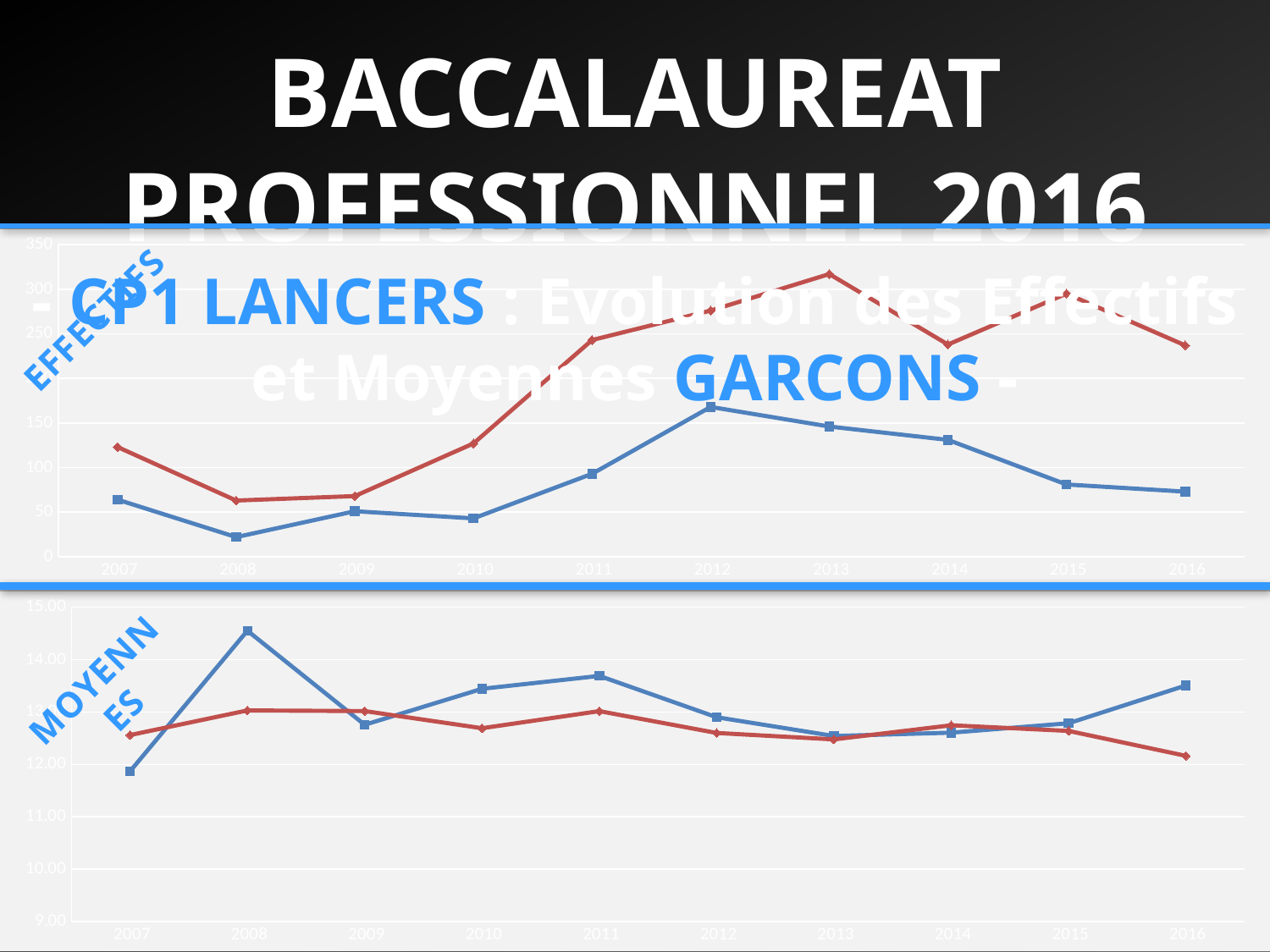
In the top chart (EFFECTIFS), in which year does the red line reach its highest value? 2013 In the bottom chart (MOYENNES), in which year does the blue line reach its highest value? 2008 In the bottom chart (MOYENNES), in which year is the red line at its lowest? 2016 In the top chart (EFFECTIFS), which line has the larger value in 2013, the red line or the blue line? the red line In the top chart (EFFECTIFS), in which year is the blue line at its lowest? 2008 In the top chart (EFFECTIFS), in which year does the blue line reach its highest value? 2012 In the top chart (EFFECTIFS), does the blue line rise or fall from 2012 to 2016? fall In the top chart (EFFECTIFS), is the value of the blue line in 2008 greater or less than 50? less In the bottom chart (MOYENNES), is the value of the blue line in 2008 greater or less than 14.00? greater In the top chart (EFFECTIFS), is the value of the red line in 2013 greater or less than 300? greater What kind of chart is the top chart labelled EFFECTIFS? line chart In the top chart (EFFECTIFS), how many years are shown on the x axis? 10